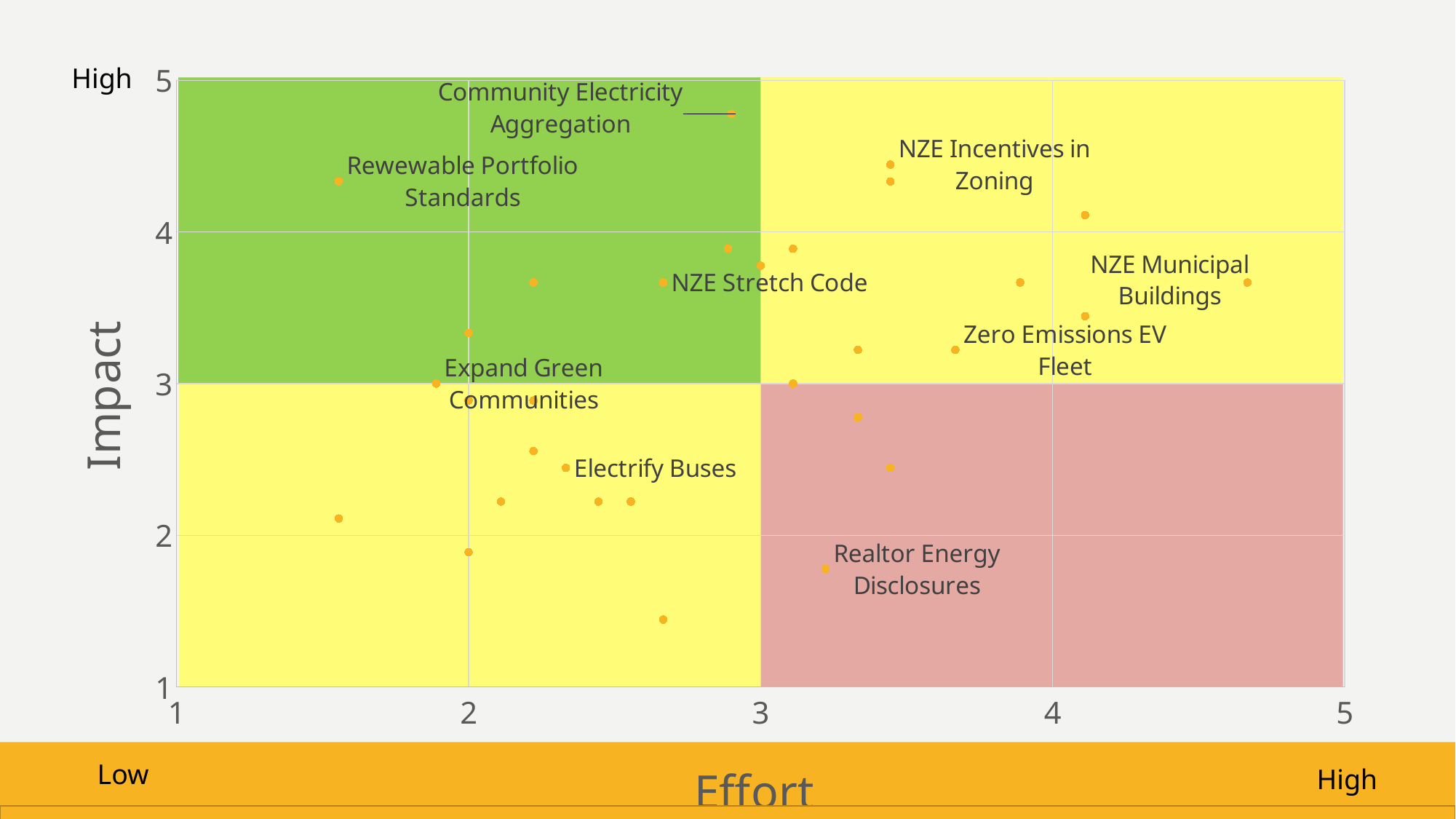
Is the Effort value for NZE Municipal Buildings greater or less than 4? greater What kind of chart is shown on the slide? scatter chart What is the title of the vertical axis? Impact Which has the higher Impact value, Community Electricity Aggregation or Realtor Energy Disclosures? Community Electricity Aggregation Is the Impact value for Electrify Buses greater or less than 3? less Among the labeled points, which has the highest Effort value? NZE Municipal Buildings Is the Effort value for Renewable Portfolio Standards greater or less than 2? less What is the title of the horizontal axis? Effort Among the labeled points, which has the lowest Impact value? Realtor Energy Disclosures